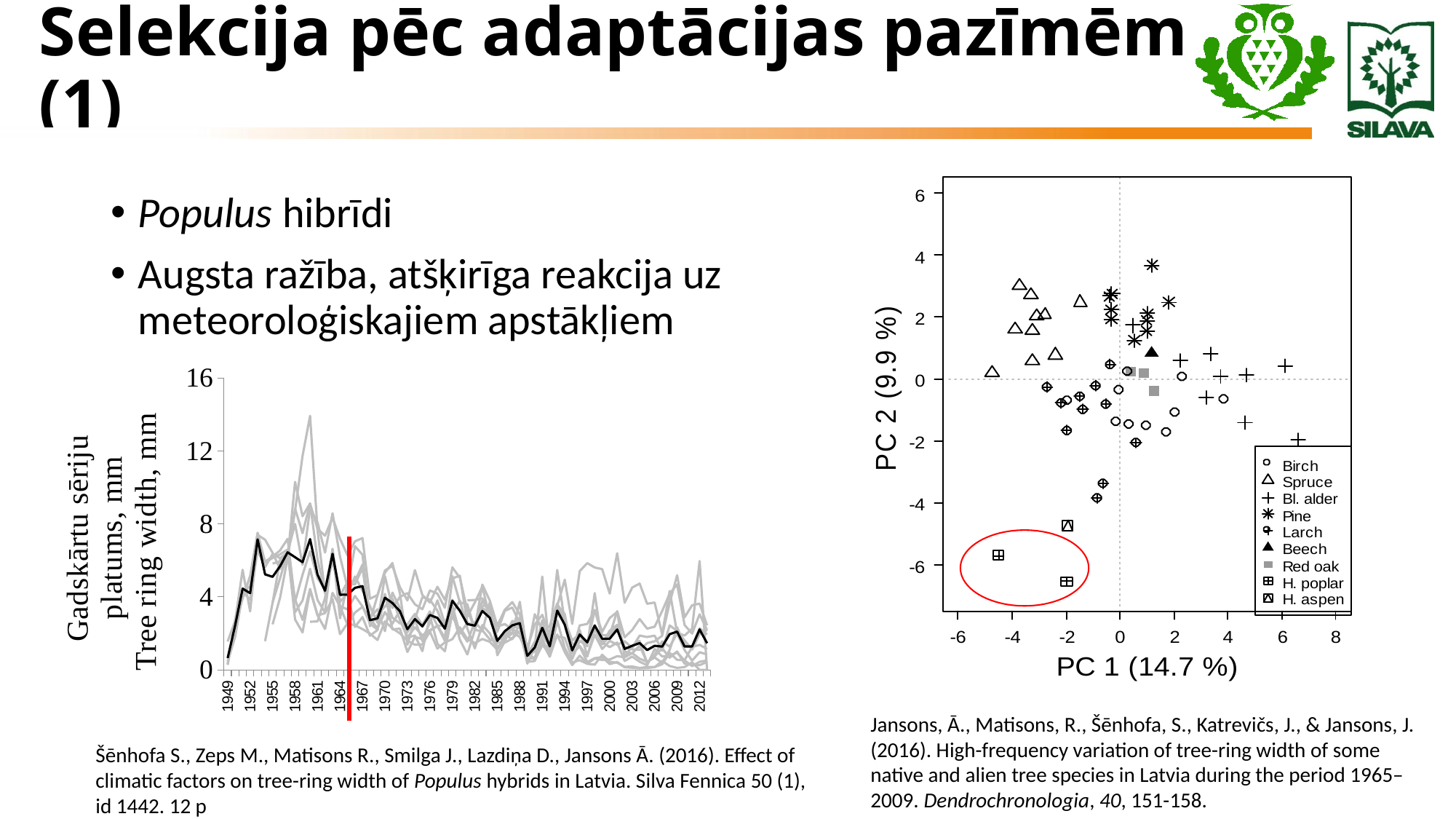
In the left chart, what is the last year shown on the x axis? 2012 In the right chart, are the PC 2 values of the H. poplar points greater or less than -4? less In the left chart, what is the first year shown on the x axis? 1949 How many series does the legend of the right chart list? 9 In the left chart, what is the label of the y axis? Tree ring width, mm In the left chart, does the black line generally rise or fall from the 1950s to 2012? fall What kind of chart is the chart on the left of the slide? line chart In the left chart, what is the highest value shown on the y axis? 16 What kind of chart is the chart on the right of the slide? scatter plot In the right chart, what is the label of the x axis? PC 1 (14.7 %) In the right chart, how many H. poplar points are inside the red ellipse? 2 In the left chart, is the value of the black line in 2012 greater or less than 4? less